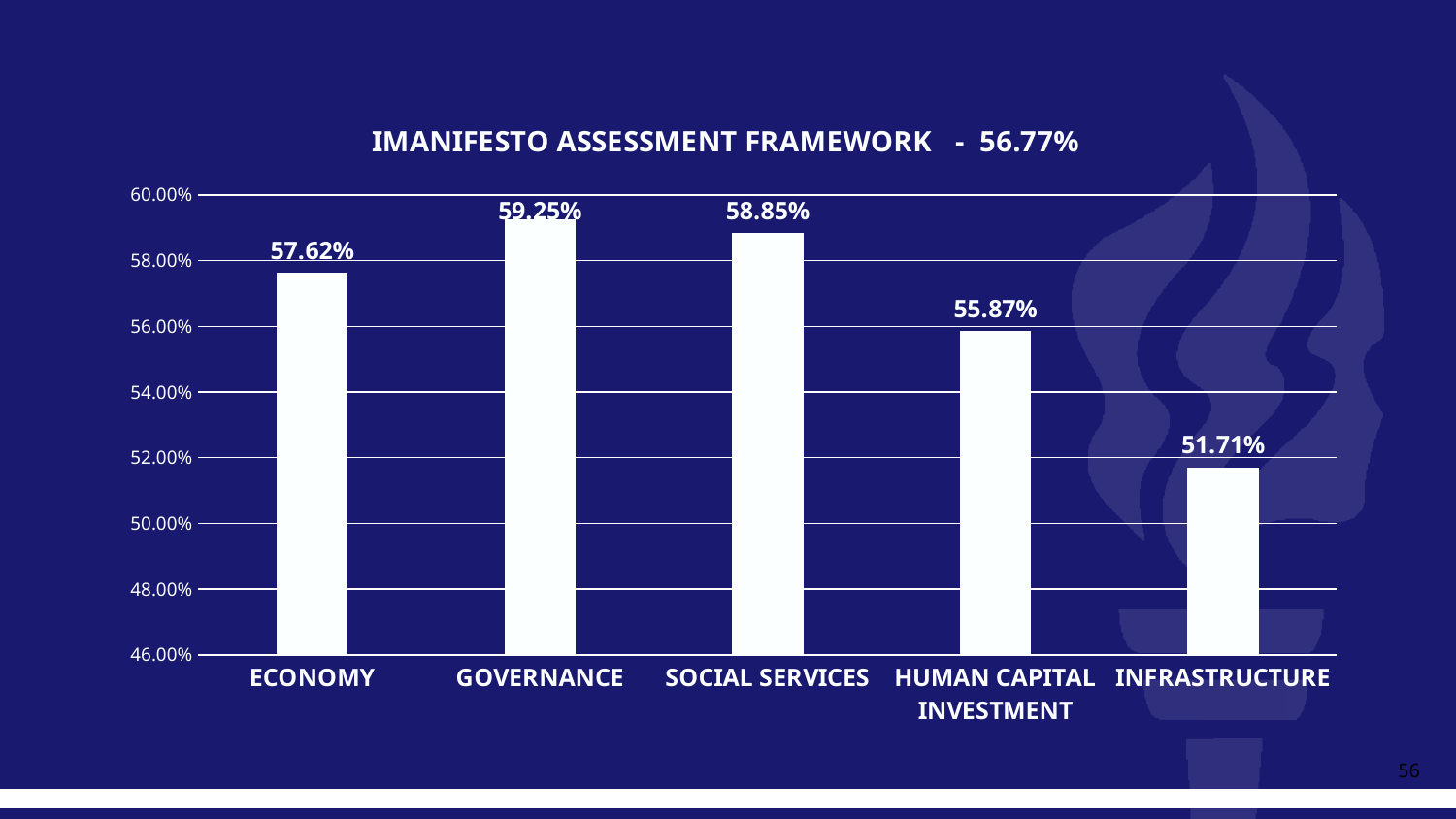
Which category has the highest value? Governance How many categories are shown on the chart? 5 What is the value for Economy? 57.62% What is the value for Human Capital Investment? 55.87% What is the value for Infrastructure? 51.71% Which is larger, the value for Economy or the value for Human Capital Investment? Economy What is the title of the chart? IMANIFESTO ASSESSMENT FRAMEWORK - 56.77% Is the value for Infrastructure greater or less than 52.00%? less What kind of chart is shown on the slide? bar chart Which category has the lowest value? Infrastructure What is the difference between the values for Governance and Infrastructure? 7.54% What is the difference between the values for Social Services and Human Capital Investment? 2.98%